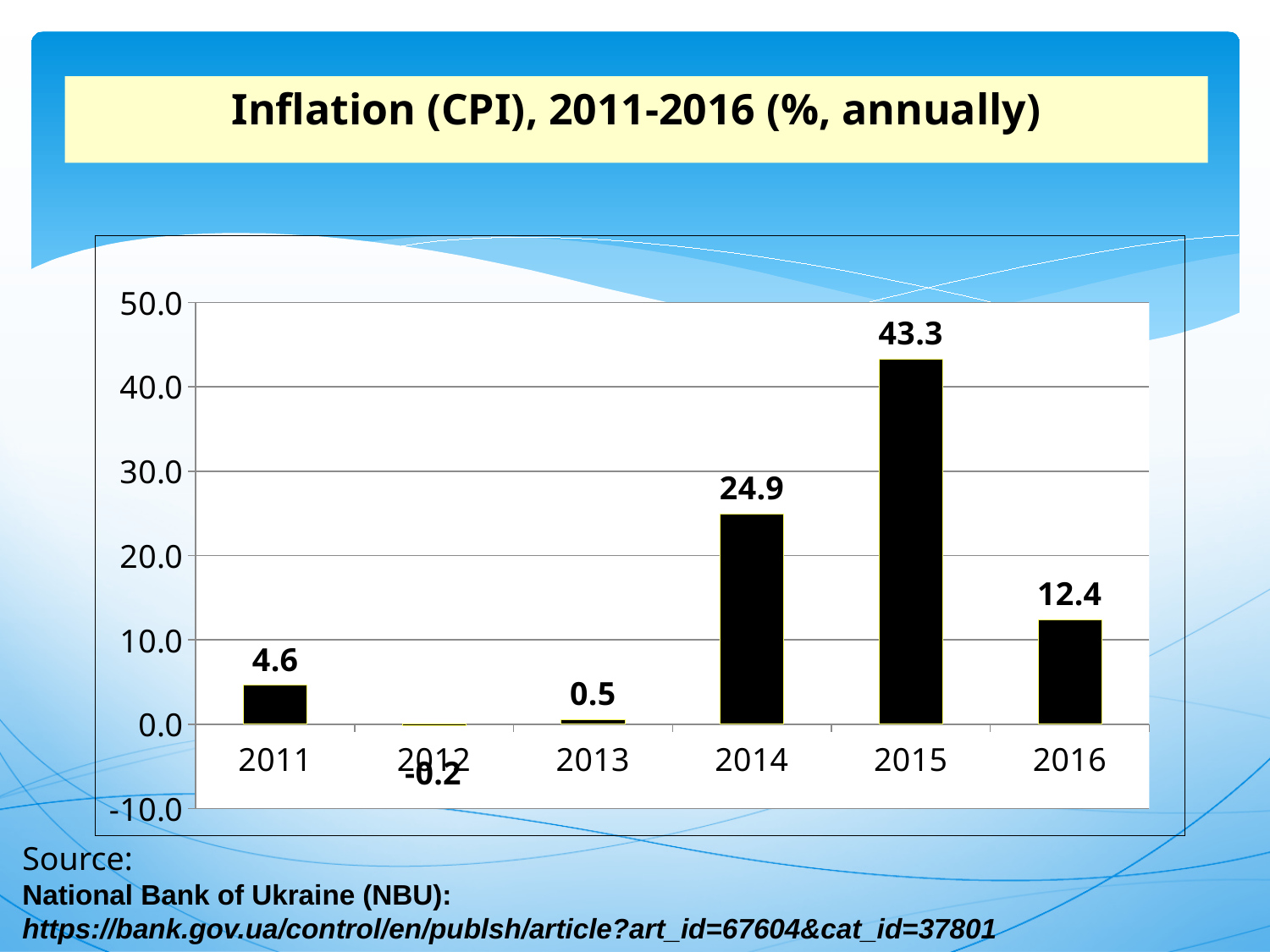
How many years are shown on the x axis? 6 What is the inflation value for 2015? 43.3 What is the inflation value for 2011? 4.6 Which year has the lowest inflation value? 2012 Which year has the larger inflation value, 2016 or 2011? 2016 What kind of chart is shown on the slide? Bar chart What is the difference between the inflation values for 2015 and 2014? 18.4 What is the title of the chart? Inflation (CPI), 2011-2016 (%, annually) What is the inflation value for 2014? 24.9 What is the inflation value for 2016? 12.4 Which year has the highest inflation value? 2015 Is the value for 2014 greater or less than 20.0? greater